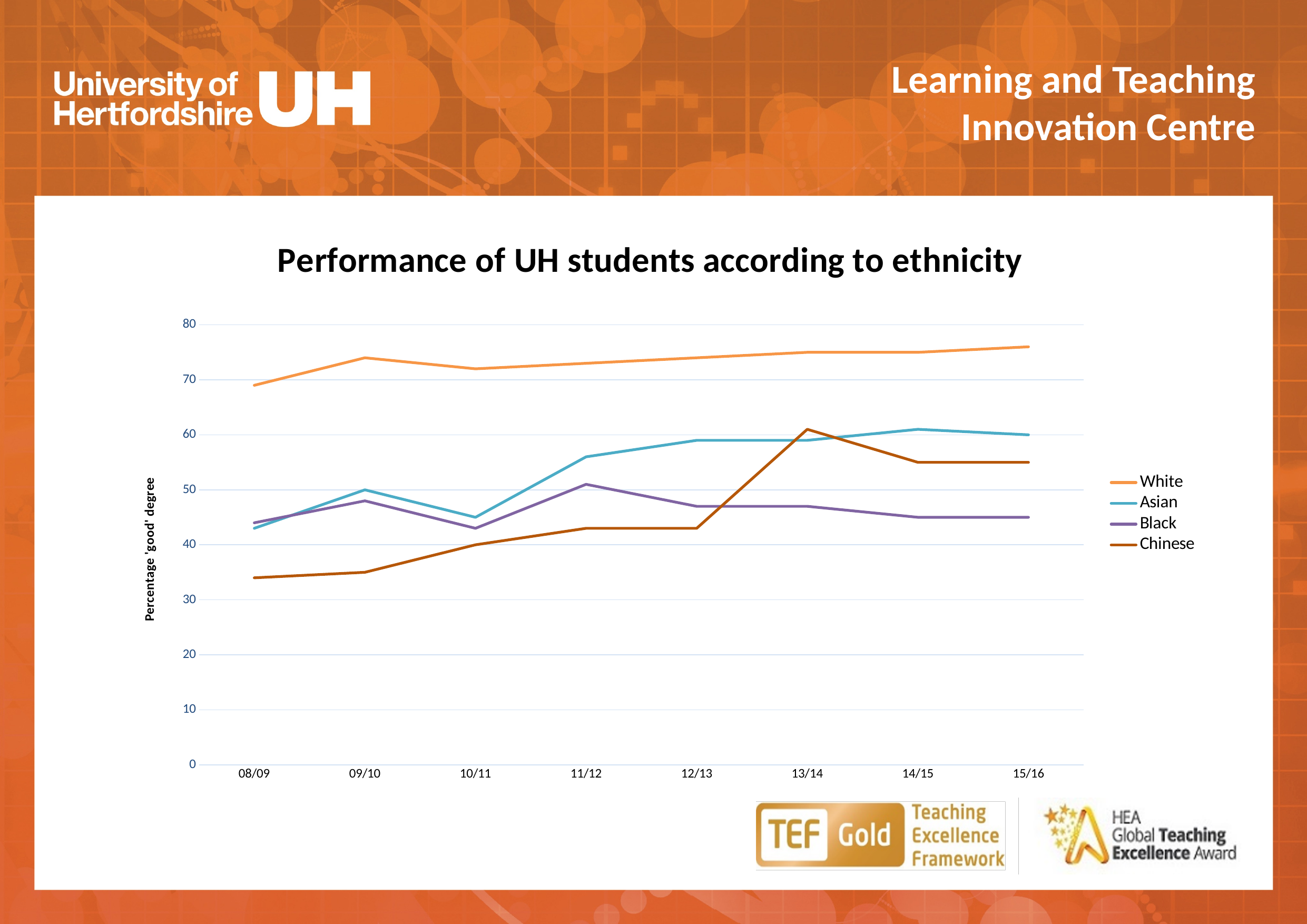
Does the White series generally rise or fall from 08/09 to 15/16? rise How many academic years are plotted along the x axis? 8 In 12/13, which group has the higher value, Asian or Black? Asian How many series does the legend list? 4 What is the title of the chart? Performance of UH students according to ethnicity Is the value for Chinese students in 08/09 greater or less than 40? less Is the value for Asian students in 11/12 greater or less than 50? greater Which ethnic group has the lowest percentage of 'good' degrees in 08/09? Chinese Is the value for White students in 15/16 greater or less than 70? greater Which ethnic group has the highest percentage of 'good' degrees in 15/16? White What kind of chart is shown on the slide? line chart